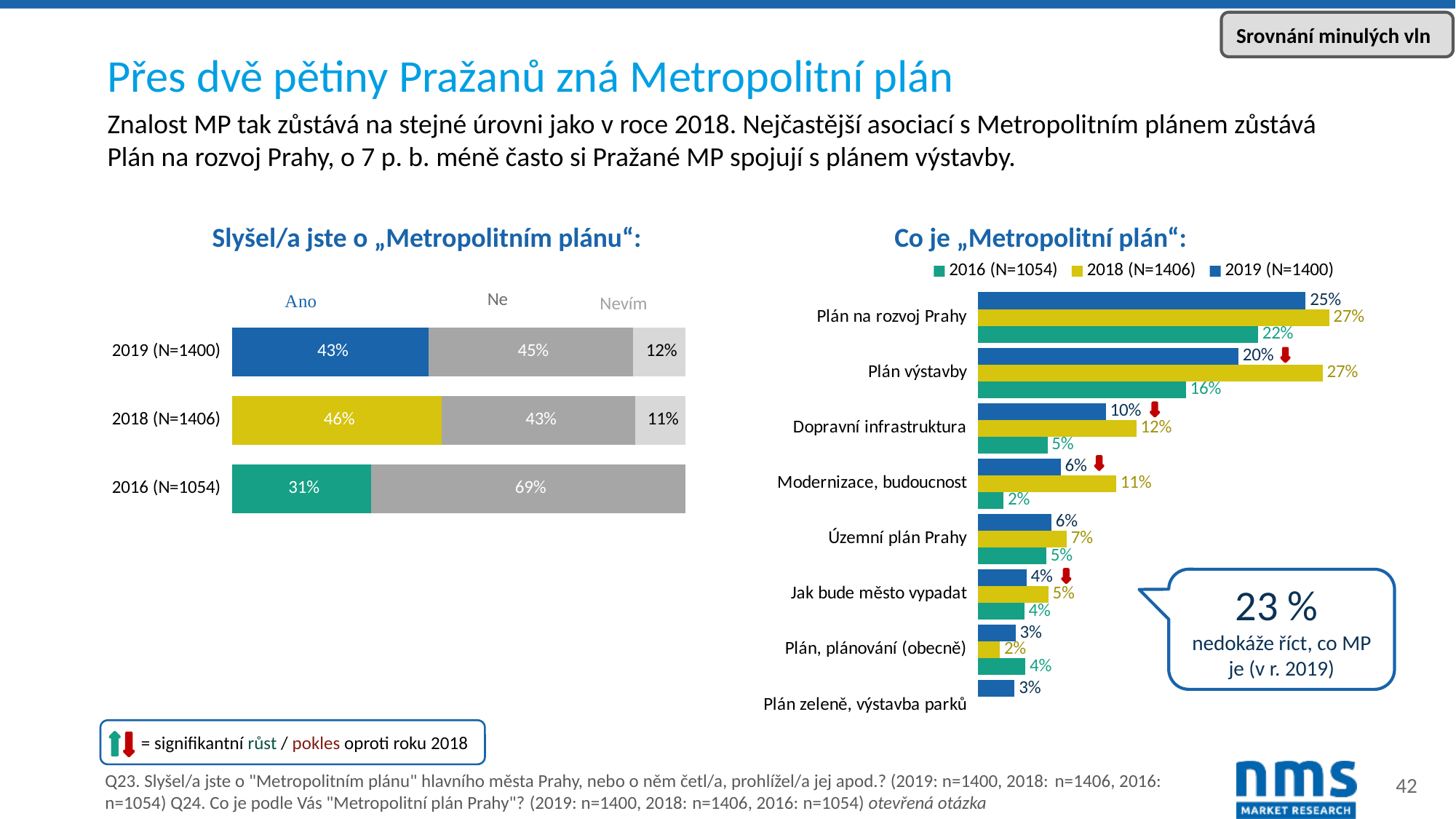
In the chart "Slyšel/a jste o „Metropolitním plánu“", what is the difference between the Ano share in 2018 and in 2019? 3 p. b. In the chart "Co je „Metropolitní plán“", what is the 2016 value for Modernizace, budoucnost? 2% In the chart "Slyšel/a jste o „Metropolitním plánu“", what share answered Ne in 2016 (N=1054)? 69% In the chart "Co je „Metropolitní plán“", how many categories are listed on the vertical axis? 8 In the chart "Co je „Metropolitní plán“", is the 2019 value for Dopravní infrastruktura larger or smaller than the 2018 value? Smaller In the chart "Slyšel/a jste o „Metropolitním plánu“", which year has the highest Ano share? 2018 (N=1406) In the chart "Slyšel/a jste o „Metropolitním plánu“", what share answered Ano in 2019 (N=1400)? 43% In the chart "Co je „Metropolitní plán“", which category has the highest 2019 value? Plán na rozvoj Prahy In the chart "Co je „Metropolitní plán“", what is the difference between the 2018 and 2019 values for Plán výstavby? 7% In the chart "Slyšel/a jste o „Metropolitním plánu“", what type of chart is used? Stacked bar chart In the chart "Co je „Metropolitní plán“", what is the 2018 value for Plán výstavby? 27% In the chart "Co je „Metropolitní plán“", how many series does the legend list? 3